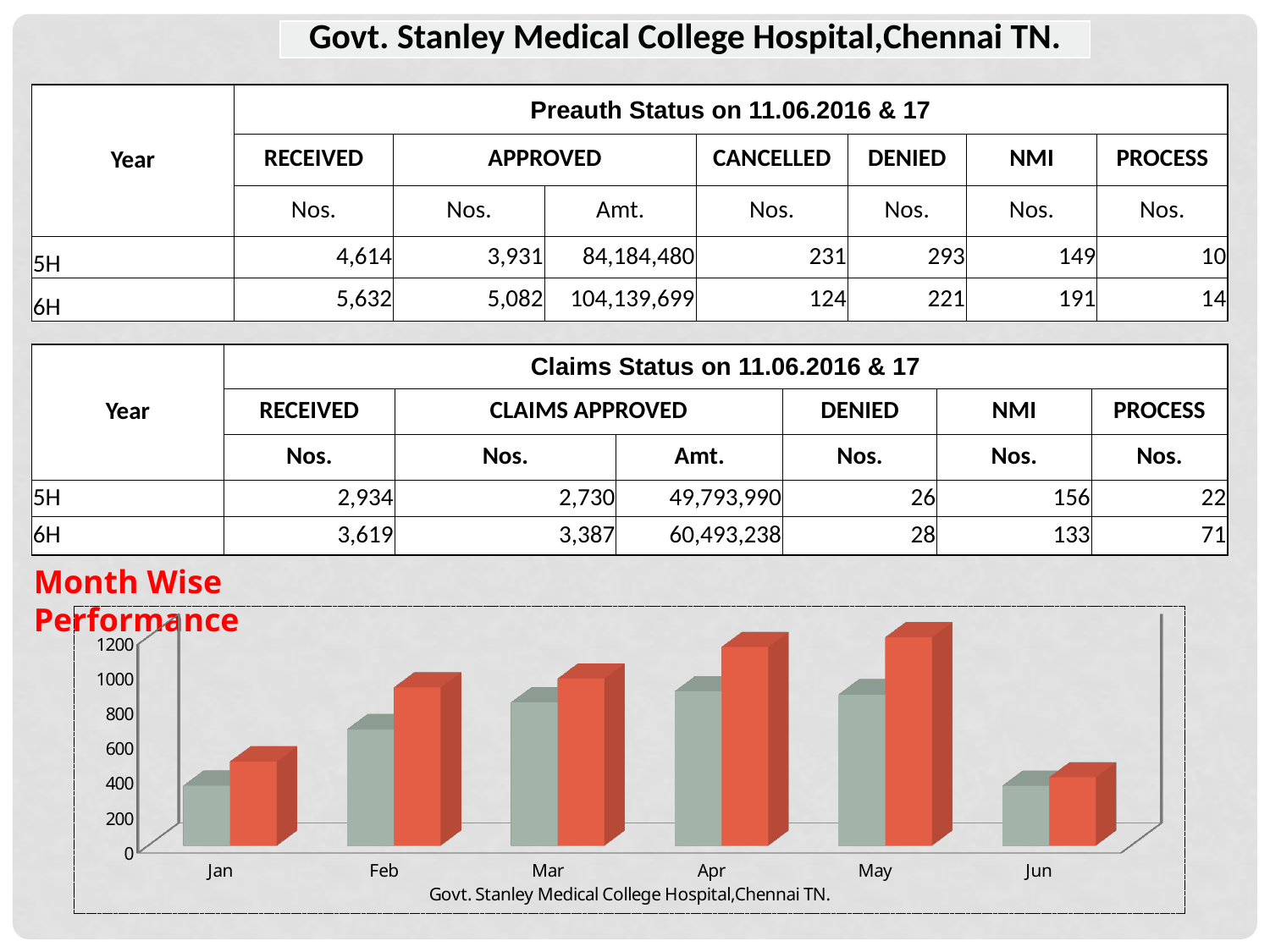
In the bar chart, which month has the tallest red bar? May In the bar chart, is the red bar for Feb greater or less than 800? greater In the bar chart, is the grey bar for Jan greater or less than 600? less In the bar chart, which month has the shortest red bar? Jun In the bar chart, which is larger: the red bar for Feb or the red bar for Jan? Feb How many months are shown on the x axis of the bar chart? 6 In the bar chart, is the red bar for May greater or less than 1000? greater In the bar chart, which is larger: the grey bar for Mar or the grey bar for Jan? Mar What is the highest value shown on the vertical axis of the bar chart? 1200 In the bar chart, do the red bars rise or fall from Jan to Apr? rise What kind of chart is shown under the heading "Month Wise Performance"? bar chart